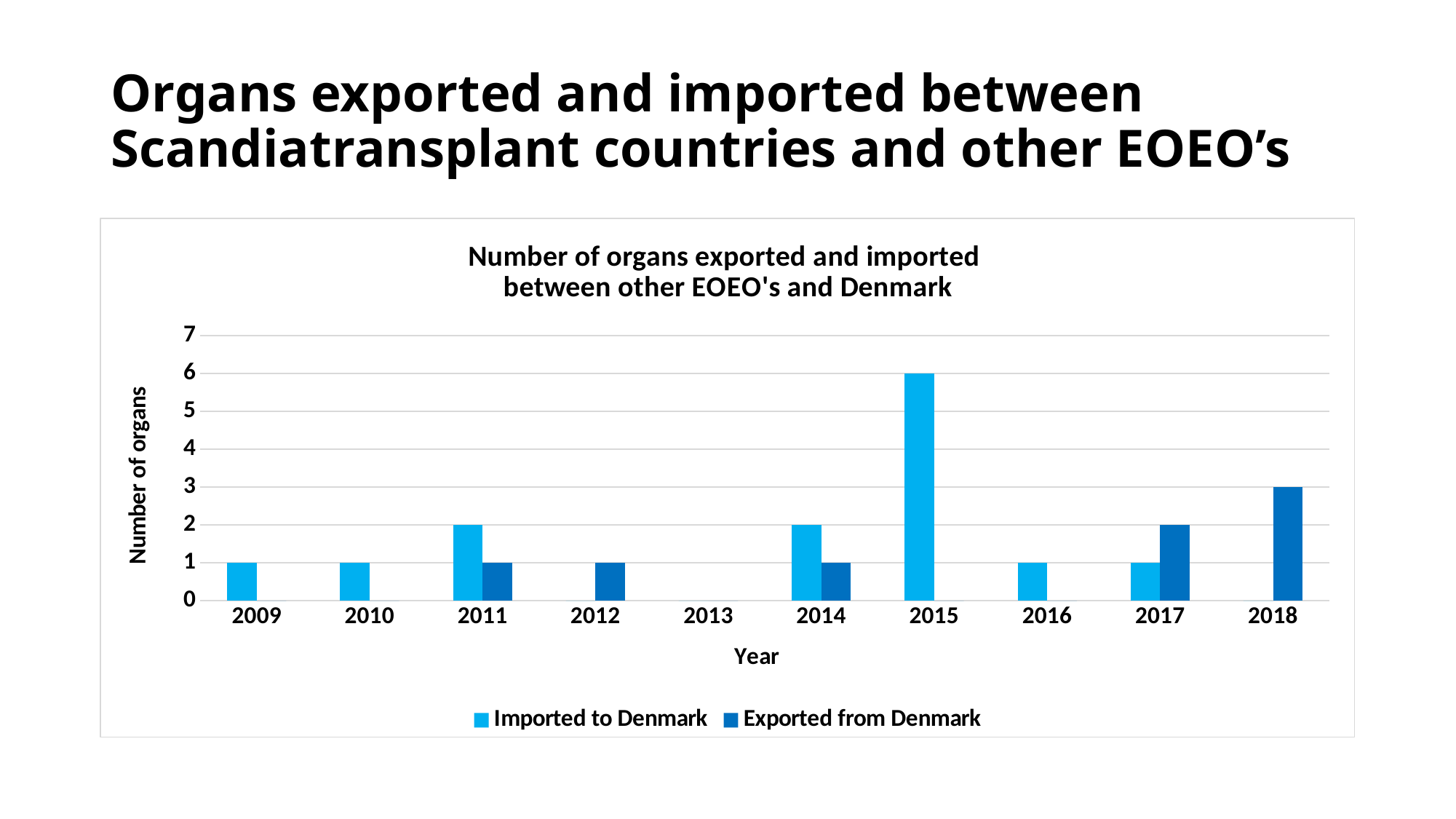
What kind of chart is shown on the slide? bar chart What is the value for Imported to Denmark in 2011? 2 What is the difference between Imported to Denmark in 2015 and Exported from Denmark in 2018? 3 What is the value for Exported from Denmark in 2018? 3 What is the label of the y axis? Number of organs In which year is the Exported from Denmark value highest? 2018 How many years are shown on the x axis? 10 How many series does the legend list? 2 What is the value for Exported from Denmark in 2017? 2 What is the value for Imported to Denmark in 2015? 6 Which is larger in 2017: Imported to Denmark or Exported from Denmark? Exported from Denmark In which year is the Imported to Denmark value highest? 2015